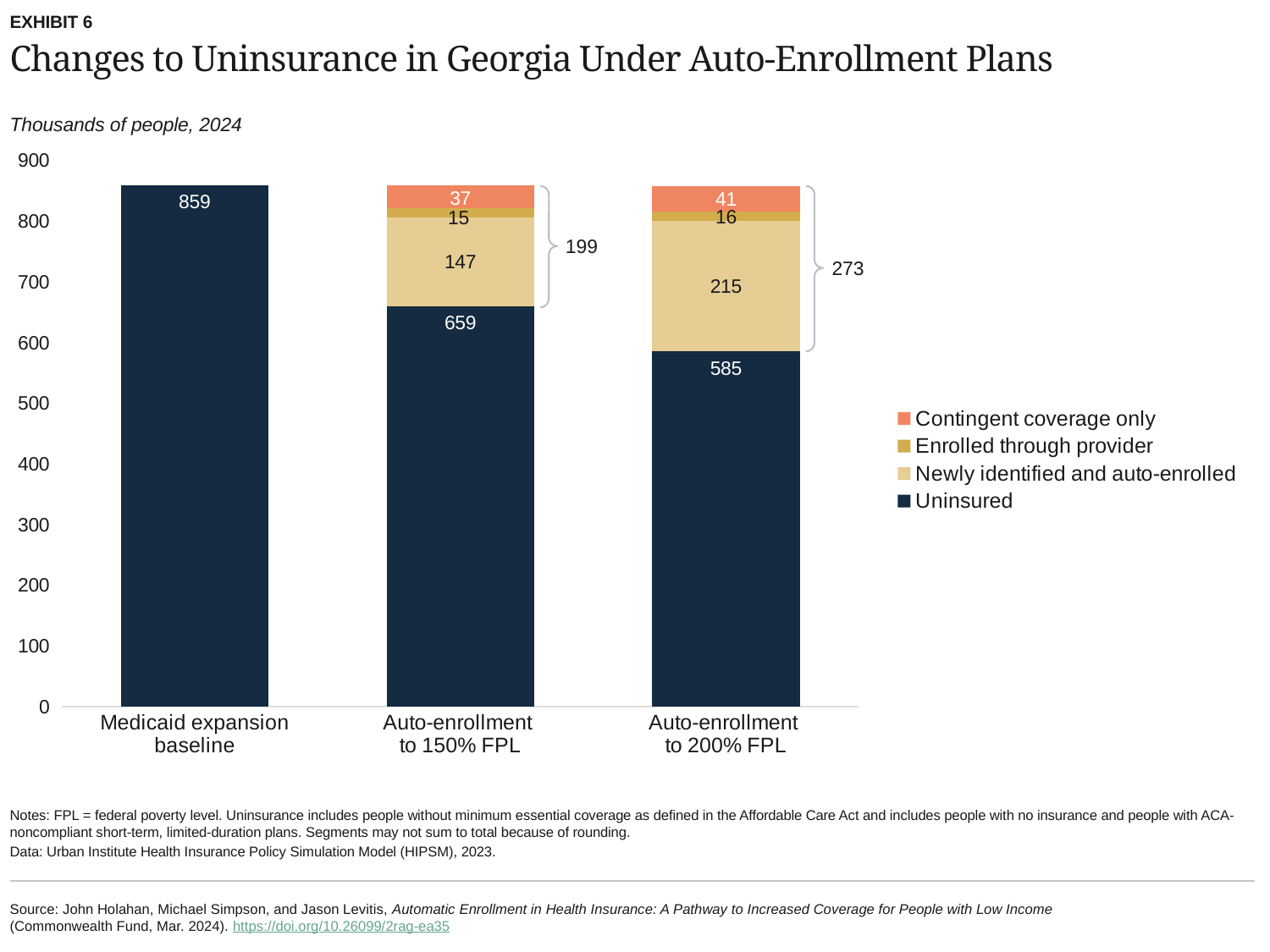
How many series does the legend list? 4 Which is larger: the Newly identified and auto-enrolled segment for Auto-enrollment to 150% FPL or for Auto-enrollment to 200% FPL? Auto-enrollment to 200% FPL What is the value of the Newly identified and auto-enrolled segment for Auto-enrollment to 150% FPL? 147 How many categories are shown on the x axis? 3 What is the value of the Contingent coverage only segment for Auto-enrollment to 200% FPL? 41 What is the difference between the Uninsured values for the Medicaid expansion baseline and Auto-enrollment to 150% FPL? 200 What is the number of uninsured people under the Medicaid expansion baseline? 859 What bracketed total is shown beside the non-uninsured segments of the Auto-enrollment to 200% FPL bar? 273 What is the value of the Enrolled through provider segment for Auto-enrollment to 150% FPL? 15 What kind of chart is shown on the slide? Stacked bar chart What is the value of the Uninsured segment for Auto-enrollment to 200% FPL? 585 Which category has the lowest Uninsured value? Auto-enrollment to 200% FPL